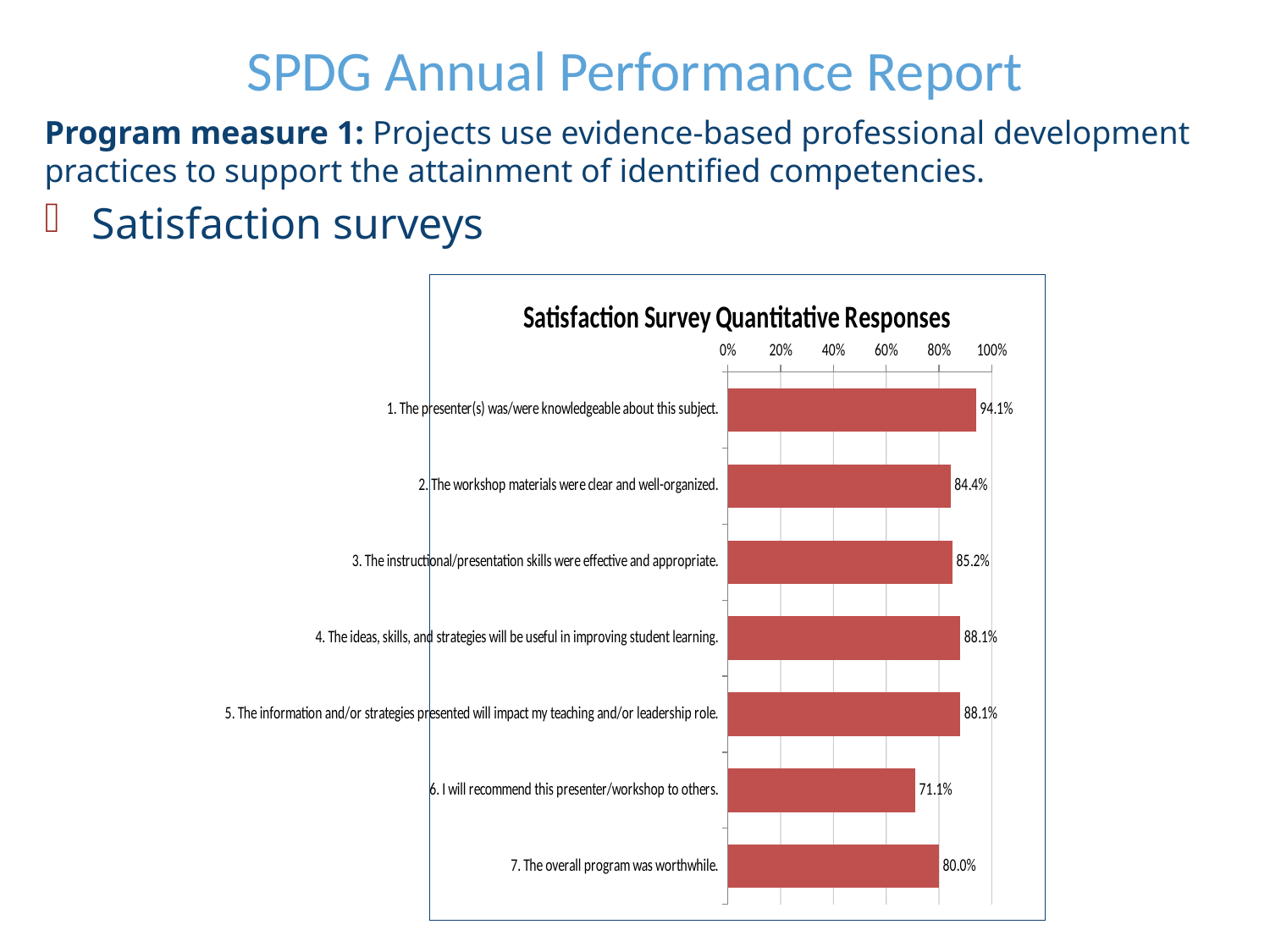
What is the value for "6. I will recommend this presenter/workshop to others."? 71.1% Which is larger, the value for item 2 or the value for item 3? 3. The instructional/presentation skills were effective and appropriate. Which survey item has the lowest value? 6. I will recommend this presenter/workshop to others. What is the value for "1. The presenter(s) was/were knowledgeable about this subject."? 94.1% What is the title of the chart? Satisfaction Survey Quantitative Responses What is the difference between the values for item 1 and item 6? 23.0% Which survey item has the highest value? 1. The presenter(s) was/were knowledgeable about this subject. How many survey items are plotted in the chart? 7 What is the value for "3. The instructional/presentation skills were effective and appropriate."? 85.2% What kind of chart is shown on the slide? Bar chart What is the value for "7. The overall program was worthwhile."? 80.0% Is the value for "7. The overall program was worthwhile." greater or less than 60%? greater